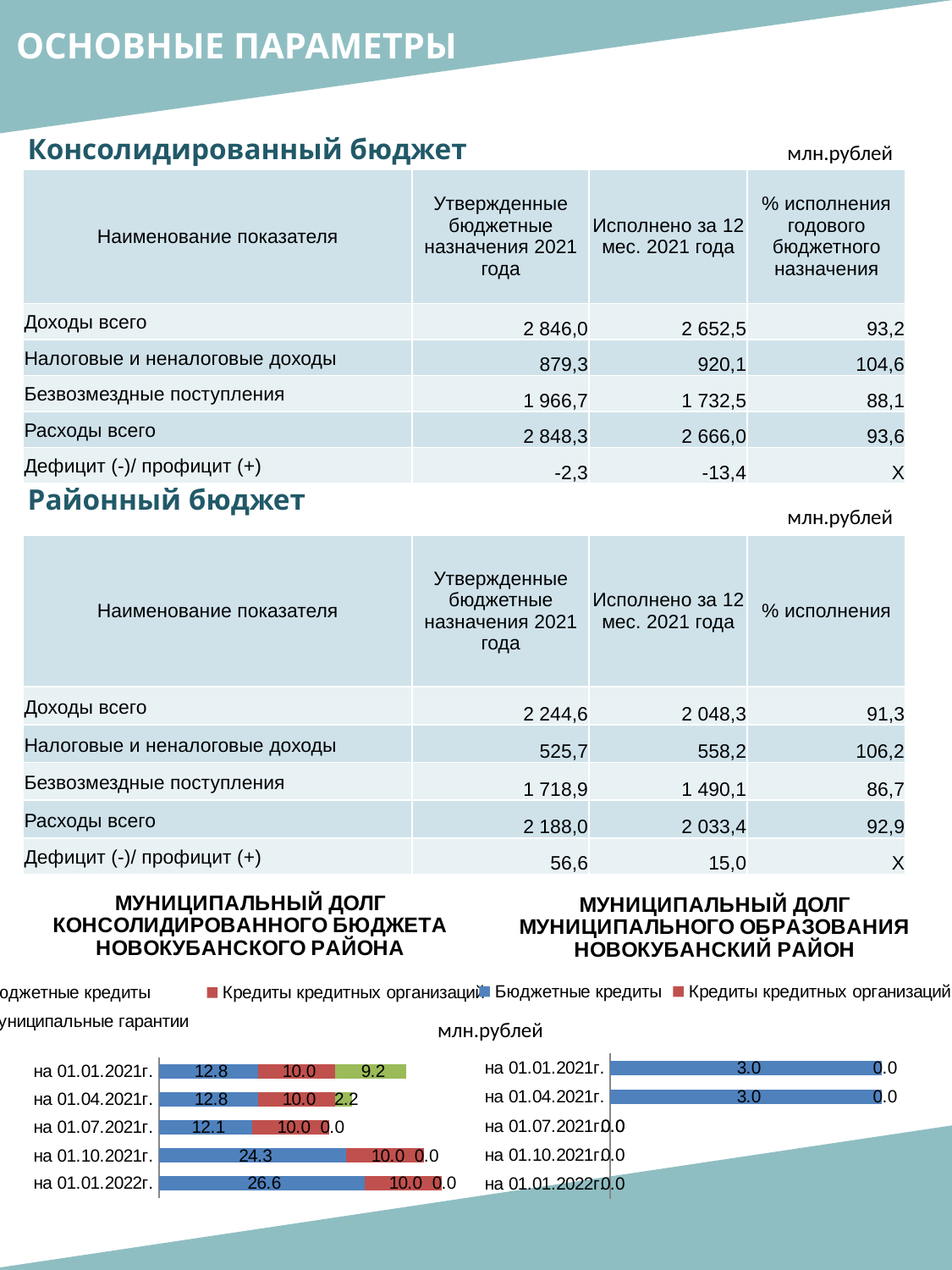
In the chart 'Муниципальный долг консолидированного бюджета Новокубанского района', what is the total municipal debt on 01.01.2021г.? 32.0 In the chart 'Муниципальный долг консолидированного бюджета Новокубанского района', what is the value of Кредиты кредитных организаций on 01.10.2021г.? 10.0 In the chart 'Муниципальный долг консолидированного бюджета Новокубанского района', what is the difference between Бюджетные кредиты on 01.01.2022г. and on 01.10.2021г.? 2.3 In the chart 'Муниципальный долг консолидированного бюджета Новокубанского района', on which date is the value of Бюджетные кредиты highest? на 01.01.2022г. In the chart 'Муниципальный долг консолидированного бюджета Новокубанского района', what is the total municipal debt on 01.01.2022г.? 36.6 In the chart 'Муниципальный долг консолидированного бюджета Новокубанского района', how many series does the legend list? 3 What type of chart is 'Муниципальный долг муниципального образования Новокубанский район'? Bar chart In the chart 'Муниципальный долг муниципального образования Новокубанский район', which is larger: Бюджетные кредиты on 01.01.2021г. or on 01.07.2021г.? на 01.01.2021г. In the chart 'Муниципальный долг консолидированного бюджета Новокубанского района', what is the value of Муниципальные гарантии on 01.01.2021г.? 9.2 In the chart 'Муниципальный долг консолидированного бюджета Новокубанского района', what is the value of Бюджетные кредиты on 01.01.2022г.? 26.6 In the chart 'Муниципальный долг консолидированного бюджета Новокубанского района', how many dates are shown on the axis? 5 In the chart 'Муниципальный долг муниципального образования Новокубанский район', what is the value of Бюджетные кредиты on 01.04.2021г.? 3.0